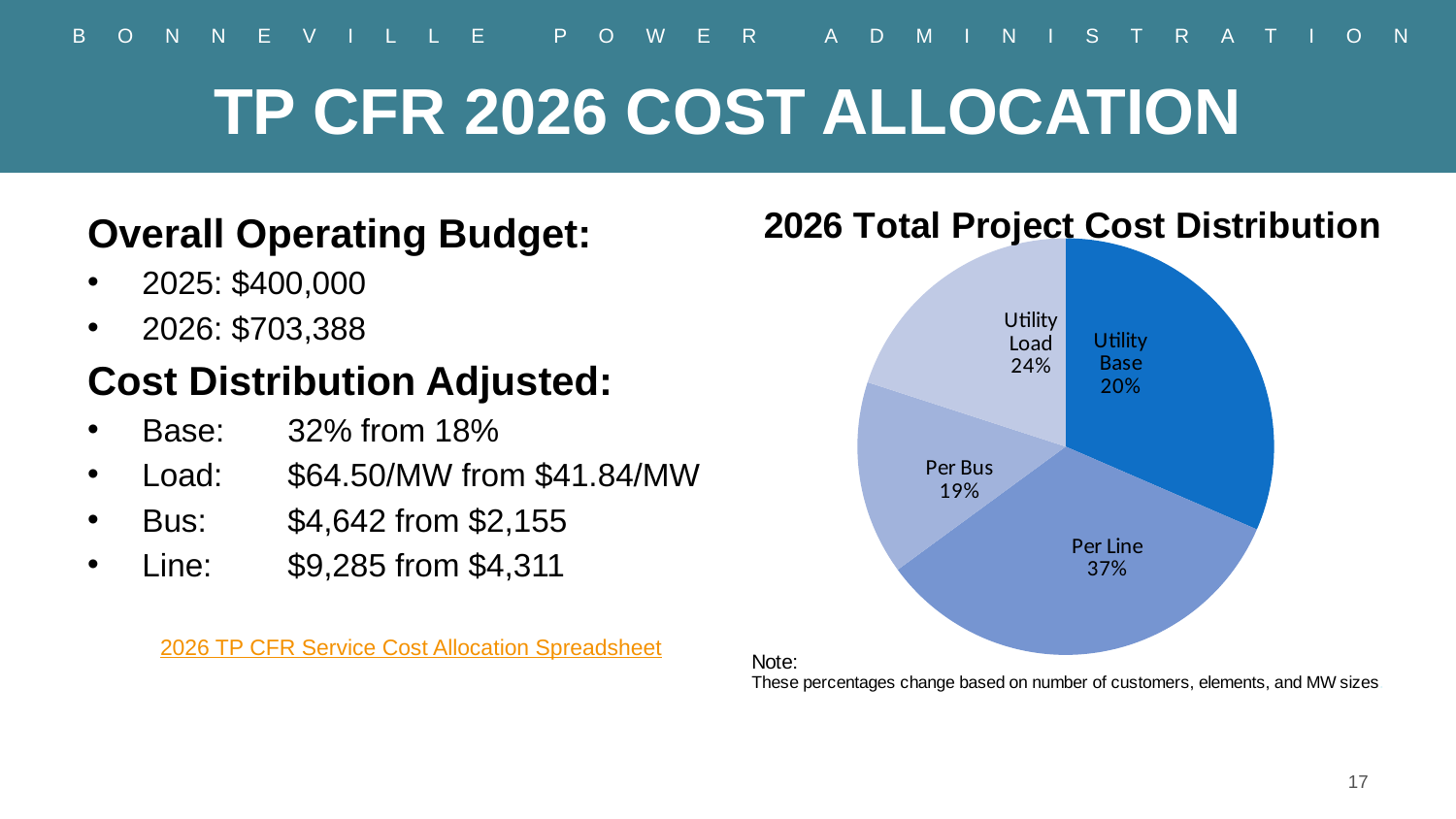
What percentage of the pie is Utility Load? 24% What is the difference in percentage points between Per Line and Utility Base? 17 What is the title of the chart? 2026 Total Project Cost Distribution What percentage of the pie is Utility Base? 20% What type of chart is shown on the slide? pie chart What percentage of the pie is Per Line? 37% Which is larger, Utility Load or Utility Base? Utility Load Which slice of the pie is the smallest? Per Bus What percentage of the pie is Per Bus? 19% How many slices does the pie chart have? 4 What is the combined share of Utility Base and Utility Load? 44% Which slice of the pie is the largest? Per Line